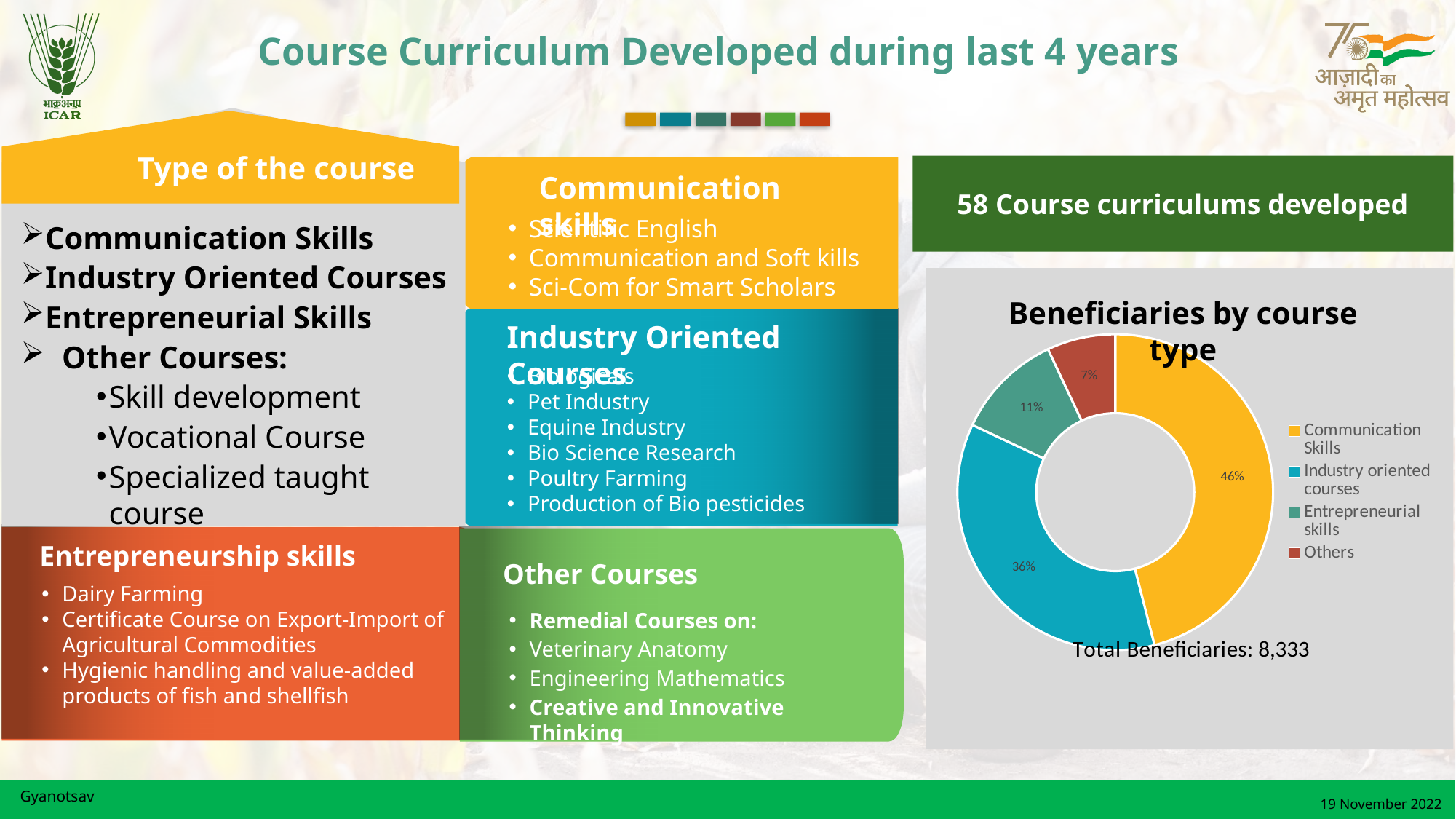
What kind of chart is 'Beneficiaries by course type'? doughnut chart What share of beneficiaries is shown for Others? 7% What share of beneficiaries is shown for Entrepreneurial skills? 11% What share of beneficiaries is shown for Communication Skills? 46% What share of beneficiaries is shown for Industry oriented courses? 36% Which course type has the largest share of beneficiaries? Communication Skills Which has a larger share of beneficiaries, Entrepreneurial skills or Others? Entrepreneurial skills What is the total number of beneficiaries stated on the chart? 8,333 Which course type has the smallest share of beneficiaries? Others What is the title of the chart on the slide? Beneficiaries by course type What is the difference in percentage points between Communication Skills and Industry oriented courses? 10 How many course types are shown in the chart? 4